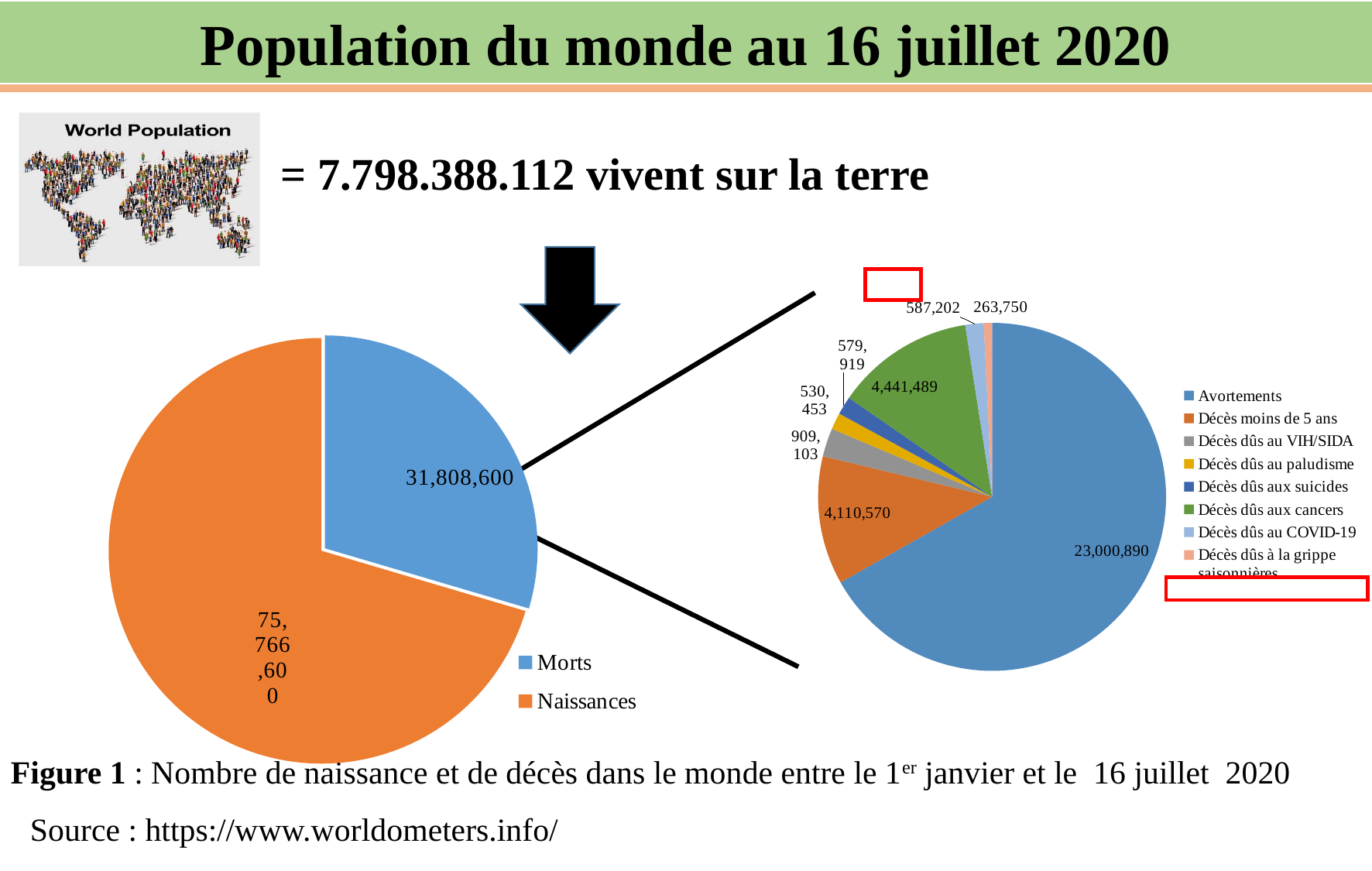
How many categories does the legend of the right pie chart list? 8 In the right pie chart, what is the value for Décès dûs aux cancers? 4,441,489 In the left pie chart, what is the difference between Naissances and Morts? 43,958,000 In the right pie chart, which category has the largest value? Avortements In the right pie chart, what is the difference between Décès dûs aux cancers and Décès moins de 5 ans? 330,919 In the right pie chart, what is the value for Décès dûs au COVID-19? 587,202 In the left pie chart, what is the value for Morts? 31,808,600 In the left pie chart, which slice is larger, Morts or Naissances? Naissances In the right pie chart, what is the value for Avortements? 23,000,890 In the right pie chart, which category has the smallest value? Décès dûs à la grippe saisonnières In the left pie chart, what is the value for Naissances? 75,766,600 What type of chart is the left chart? Pie chart